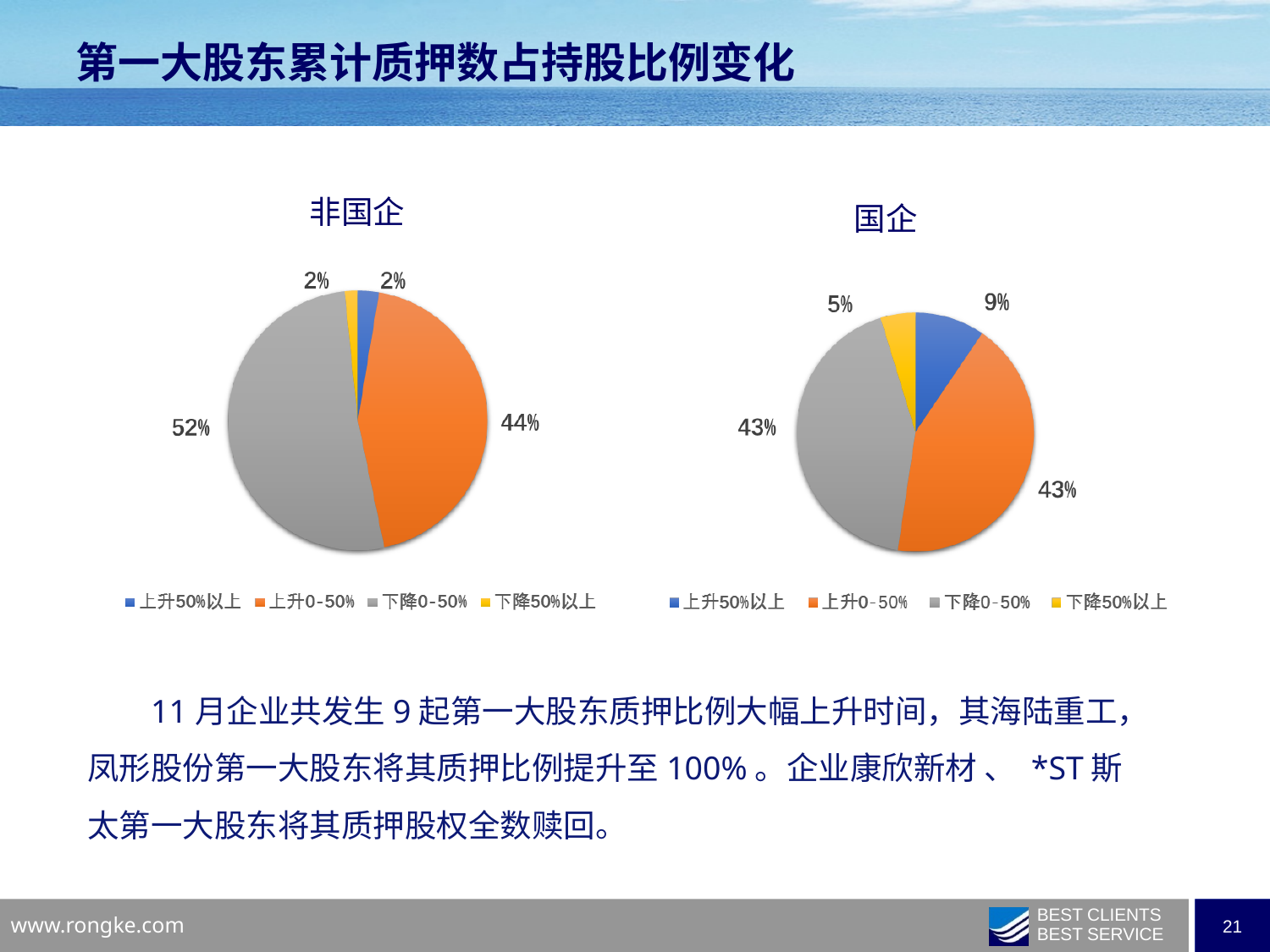
What type of chart is used for 国企? Pie chart In the 国企 pie chart, which is larger: the share for 上升50%以上 or the share for 下降50%以上? 上升50%以上 In the 非国企 pie chart, which category has the largest share? 下降0-50% In the 国企 pie chart, what share is labelled for 下降50%以上? 5% In the 国企 pie chart, what is the difference between the shares for 上升50%以上 and 下降50%以上? 4% In the 国企 pie chart, which colour represents 下降0-50%? Gray In the 非国企 pie chart, what is the difference between the shares for 下降0-50% and 上升0-50%? 8% In the 国企 pie chart, what share is labelled for 上升50%以上? 9% In the 非国企 pie chart, what share is labelled for 下降0-50%? 52% How many categories does the legend of the 非国企 chart list? 4 In the 国企 pie chart, which category has the smallest share? 下降50%以上 In the 非国企 pie chart, what share is labelled for 上升0-50%? 44%